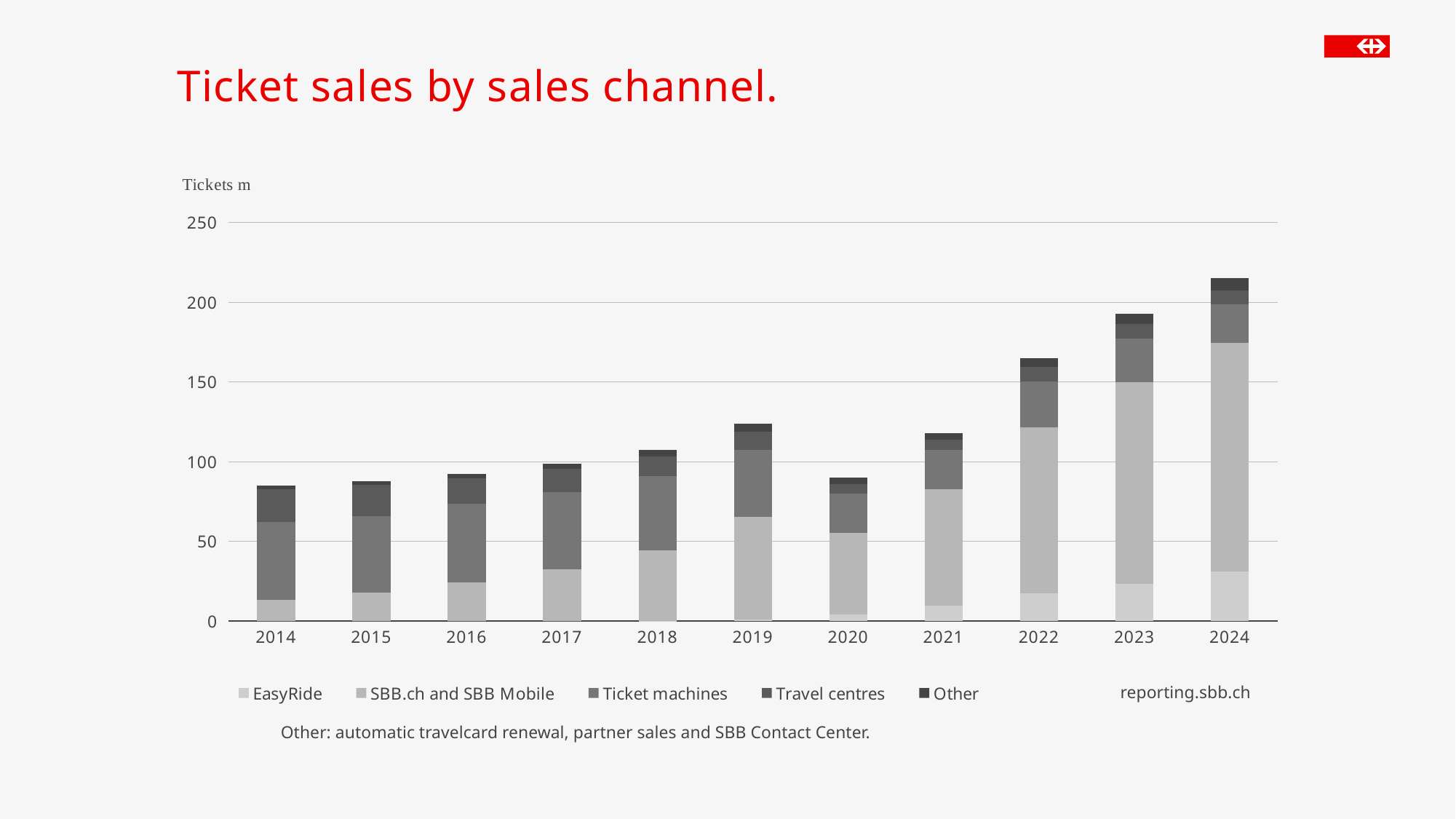
Is the total ticket sales value for 2024 greater or less than 200? greater How many series does the legend list? 5 Which year has the larger total ticket sales, 2019 or 2020? 2019 Is the total ticket sales value for 2014 greater or less than 100? less Do total ticket sales rise or fall from 2020 to 2024? Rise Is the total ticket sales value for 2022 greater or less than 150? greater Which year has the highest total ticket sales? 2024 How many years are shown on the x axis of the chart? 11 What unit label is shown above the y axis of the chart? Tickets m What kind of chart is shown on the slide? Stacked bar chart Which year has the larger total ticket sales, 2021 or 2022? 2022 What is the title of the chart on the slide? Ticket sales by sales channel.